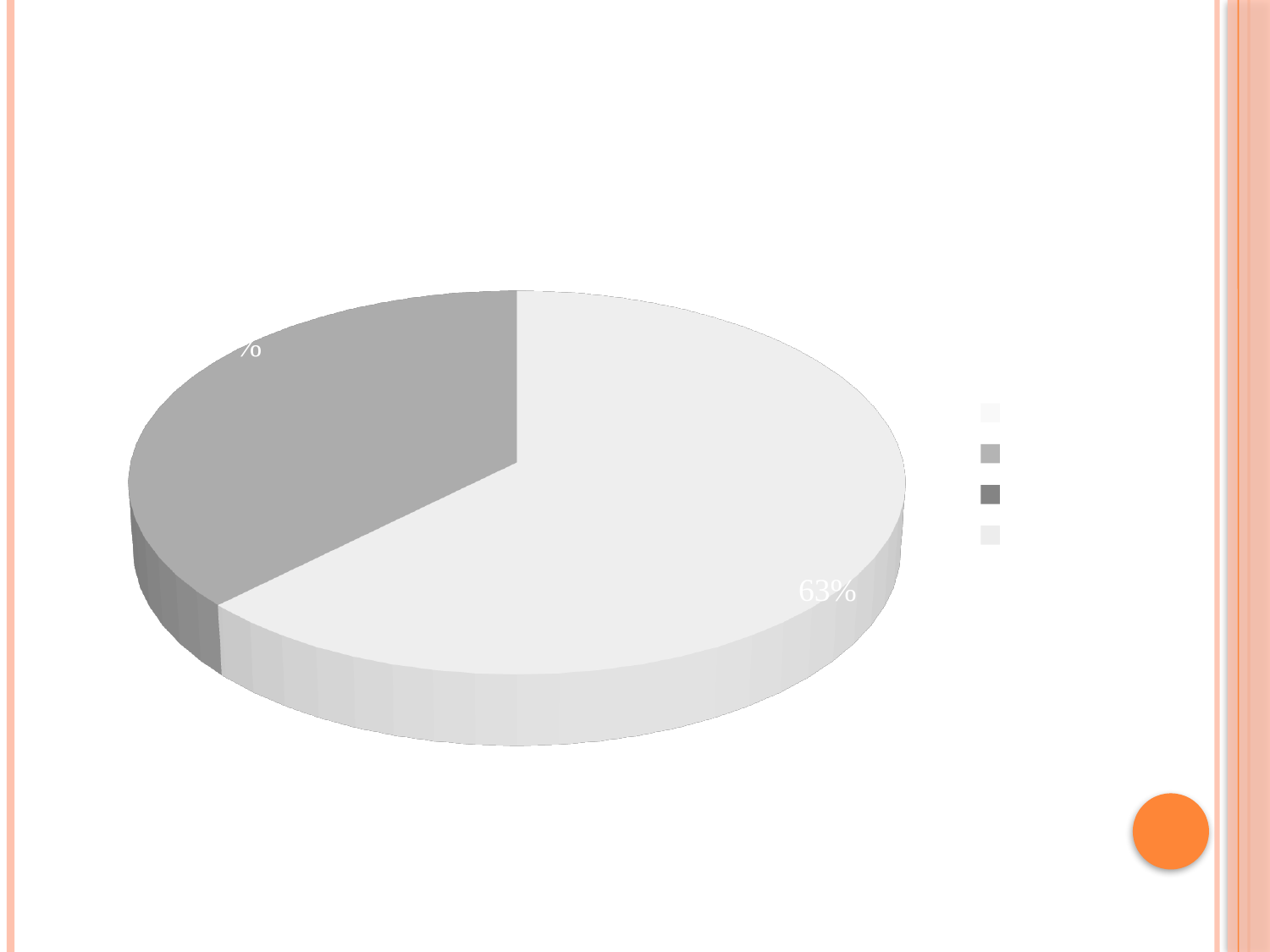
What percentage label is printed on the largest slice of the pie chart? 63% How many colour swatches does the legend of the pie chart show? 4 Which slice of the pie chart is larger, the light grey slice or the darker grey slice? the light grey slice Is the largest slice of the pie chart greater or less than 50%? greater Is the pie chart drawn in 3D? yes What kind of chart is shown on the slide? pie chart